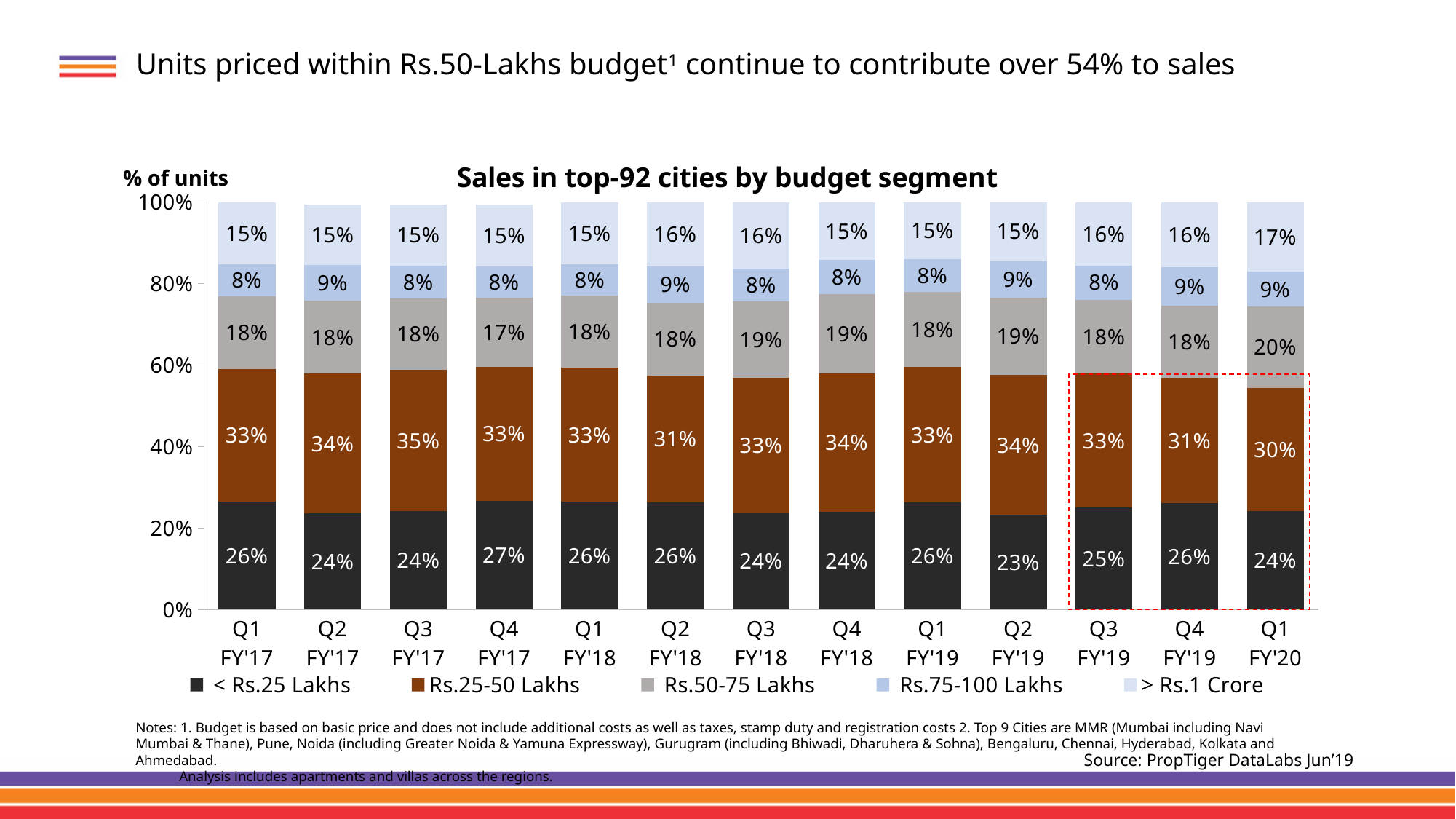
How many series does the legend list? 5 What is the value for Rs.25-50 Lakhs in Q1 FY'20? 30% In which quarter is the < Rs.25 Lakhs share lowest? Q2 FY'19 What is the value for > Rs.1 Crore in Q1 FY'20? 17% What is the difference between the Rs.25-50 Lakhs share in Q3 FY'17 and in Q1 FY'20? 5 percentage points What is the combined share of < Rs.25 Lakhs and Rs.25-50 Lakhs in Q1 FY'20? 54% In which quarter is the Rs.25-50 Lakhs share highest? Q3 FY'17 What is the value for Rs.50-75 Lakhs in Q3 FY'18? 19% In which quarter is the < Rs.25 Lakhs share highest? Q4 FY'17 How many quarters are shown along the x axis? 13 Which is larger in Q1 FY'20: the Rs.50-75 Lakhs share or the > Rs.1 Crore share? Rs.50-75 Lakhs What kind of chart is shown on the slide? Stacked bar chart